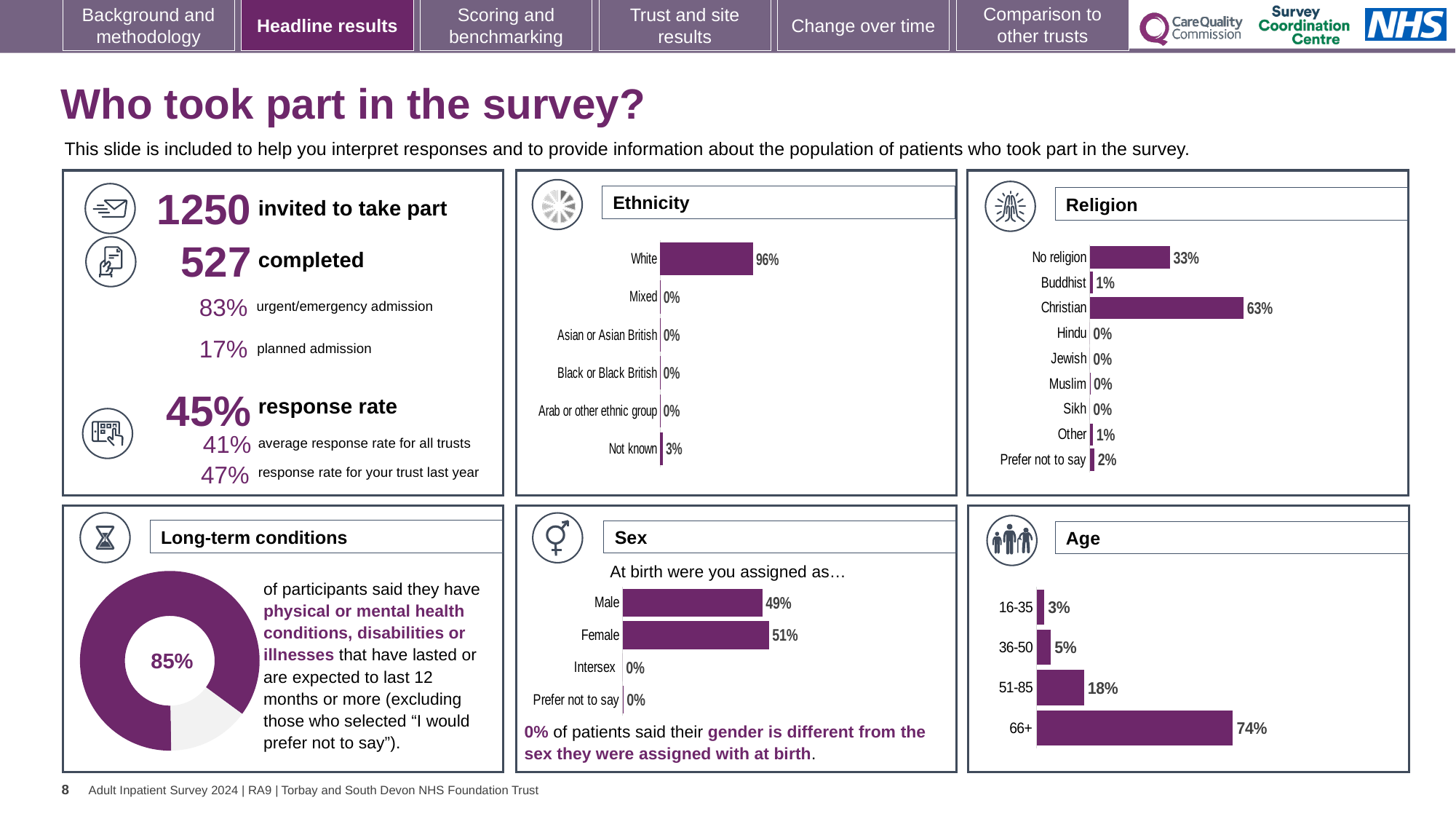
What kind of chart is the Long-term conditions chart? Doughnut chart In the Religion chart, what is the value for No religion? 33% In the Religion chart, what is the difference between the Christian and No religion values? 30% In the Age chart, which age group has the highest value? 66+ In the Ethnicity chart, what percentage of participants were White? 96% In the Sex chart, which is larger, Male or Female? Female How many categories does the Religion chart show? 9 In the Religion chart, which religion category has the highest value? Christian In the Age chart, what is the value for 51-85? 18% In the Age chart, what is the difference between the 66+ and 16-35 values? 71% In the Ethnicity chart, what percentage of participants had ethnicity Not known? 3% In the Sex chart, what is the value for Male? 49%